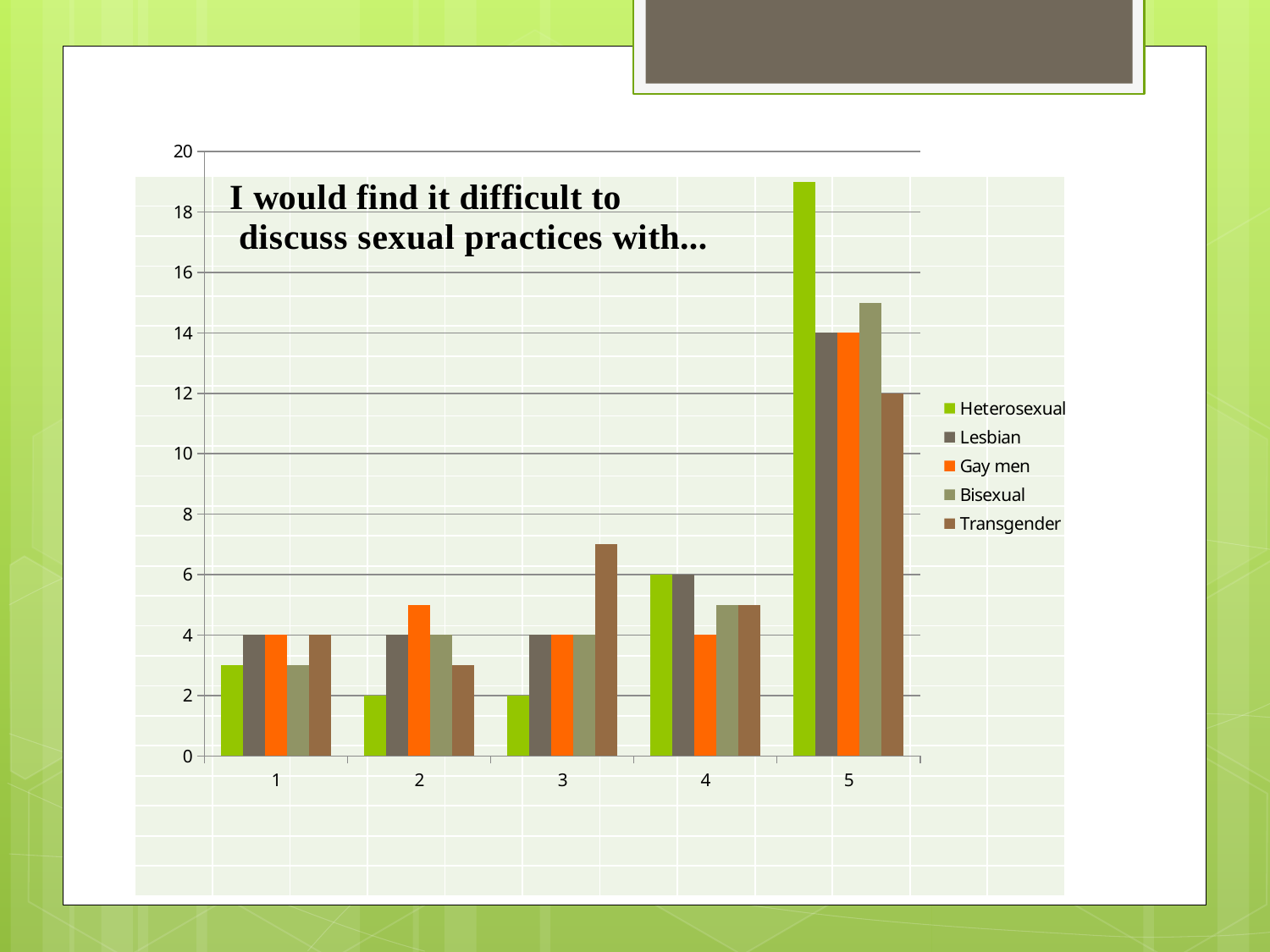
Which series has the lowest value in category 3? Heterosexual What is the difference between the Lesbian and Transgender values in category 5? 2 What is the value for Heterosexual in category 4? 6 What is the value for Lesbian in category 5? 14 What kind of chart is shown on the slide? bar chart What is the value for Heterosexual in category 2? 2 Is the value for Heterosexual in category 5 greater or less than 18? greater Which series has the highest value in category 5? Heterosexual What is the value for Transgender in category 5? 12 Is the value for Transgender in category 3 greater or less than 6? greater How many series does the legend list? 5 How many categories are shown on the x axis? 5